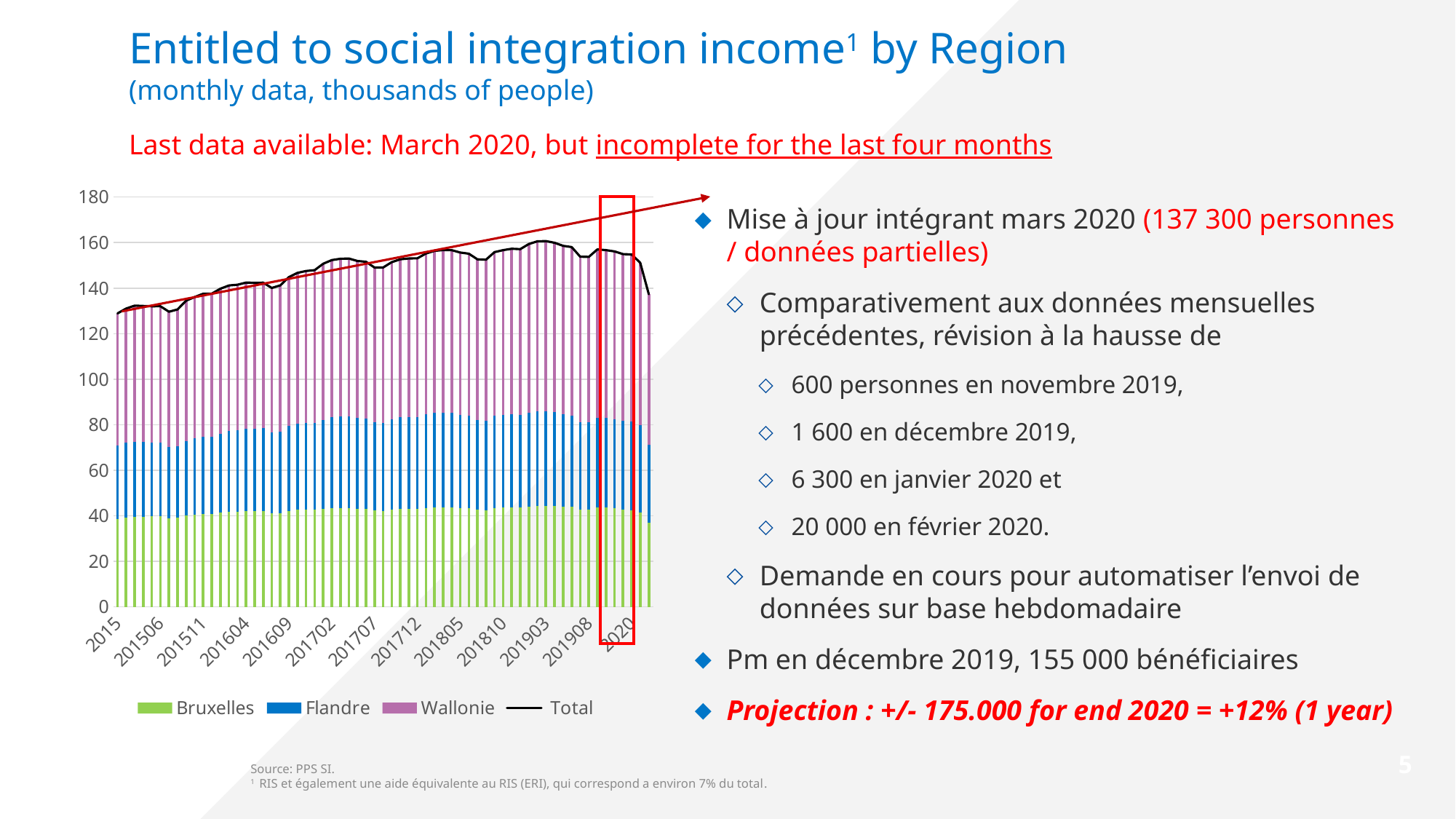
What is the highest value shown on the chart's y axis? 180 Is the Total value around 201903 greater or less than 140? greater Is the Total value at the start of 2015 greater or less than 120? greater Which series is drawn as a black line rather than bars? Total Is the Total value larger at 201903 or at 2015? 201903 Is the Total value around 201903 greater or less than 180? less Does the Total line generally rise or fall from 2015 to 2019? rise How many entries does the chart legend list? 4 Which regions are shown as stacked bars in the chart? Bruxelles, Flandre, Wallonie What kind of chart is shown on the slide? stacked bar chart with a line How many labels are printed along the x axis of the chart? 13